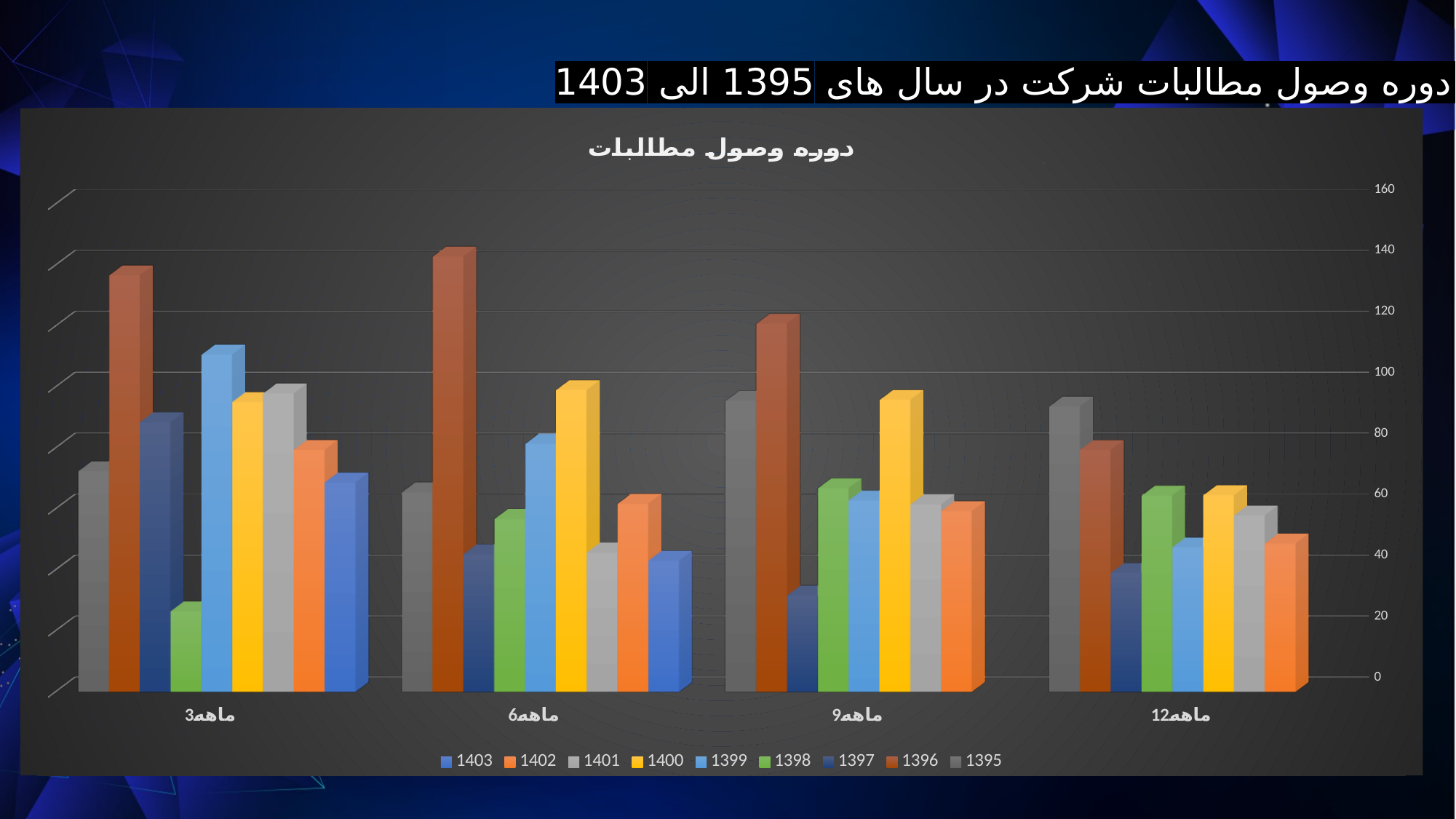
Is the value for 1396 in the 3ماهه category greater or less than 120? greater Is the value for 1398 in the 3ماهه category greater or less than 40? less How many categories are shown on the x axis? 4 How many series does the legend list? 9 What kind of chart is shown on the slide? bar chart In the 3ماهه category, which year has the highest value? 1396 What is the title of the chart? دوره وصول مطالبات In the 6ماهه category, which is larger: the value for 1400 or the value for 1398? 1400 In the 9ماهه category, which year has the highest value? 1396 In the 3ماهه category, which year has the lowest value? 1398 In the 6ماهه category, which year has the highest value? 1396 In the 9ماهه category, which year has the lowest value? 1397